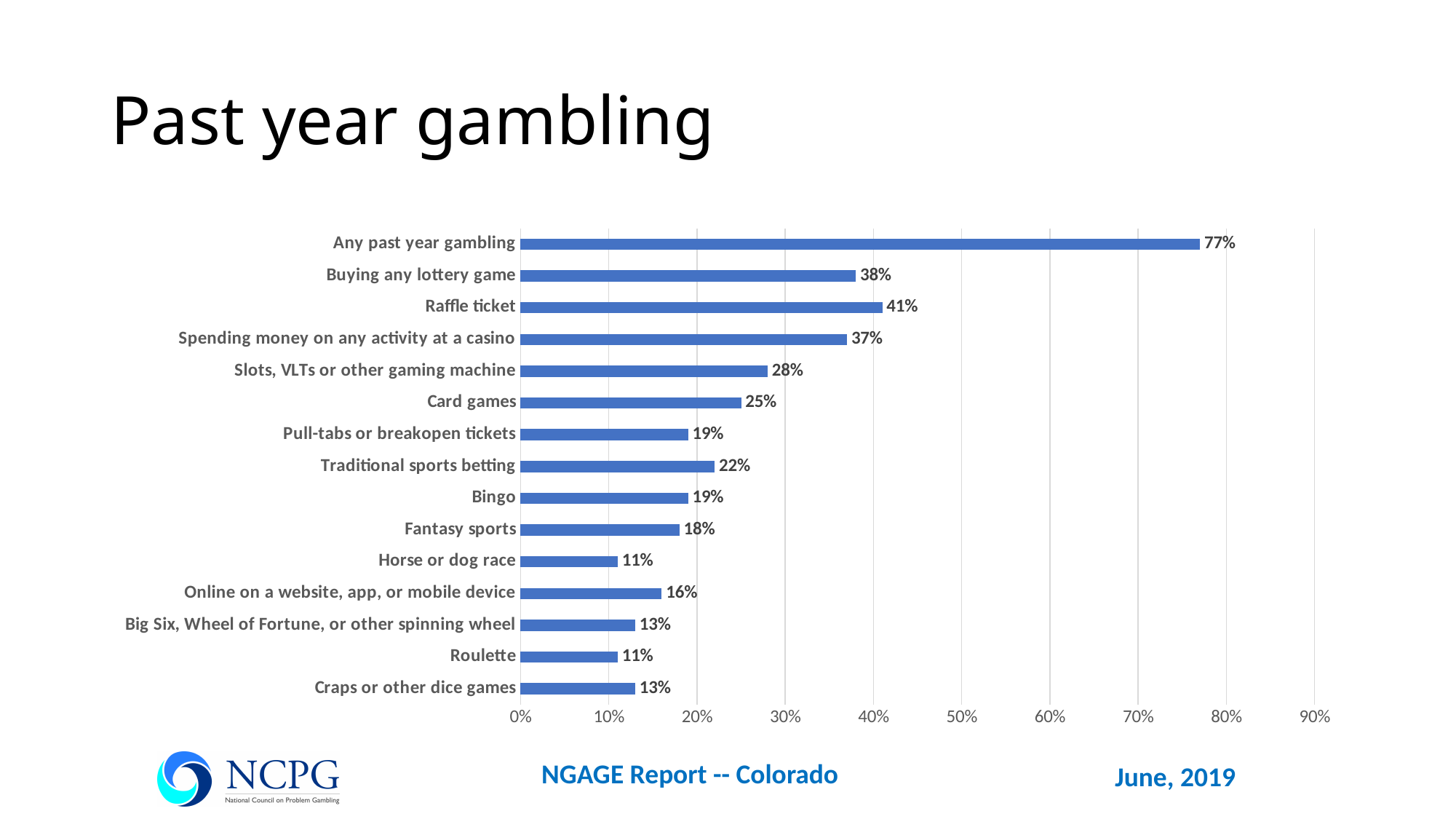
Which is larger, Fantasy sports or Horse or dog race? Fantasy sports What is the value for Raffle ticket? 41% What kind of chart is shown on the slide? Bar chart How many categories are shown in the chart? 15 Which category has the highest value? Any past year gambling What is the value for Traditional sports betting? 22% What is the difference between Any past year gambling and Spending money on any activity at a casino? 40% What is the value for Any past year gambling? 77% Which is larger, Slots, VLTs or other gaming machine or Card games? Slots, VLTs or other gaming machine What is the difference between Raffle ticket and Buying any lottery game? 3% What is the value for Online on a website, app, or mobile device? 16% What is the title of the slide? Past year gambling